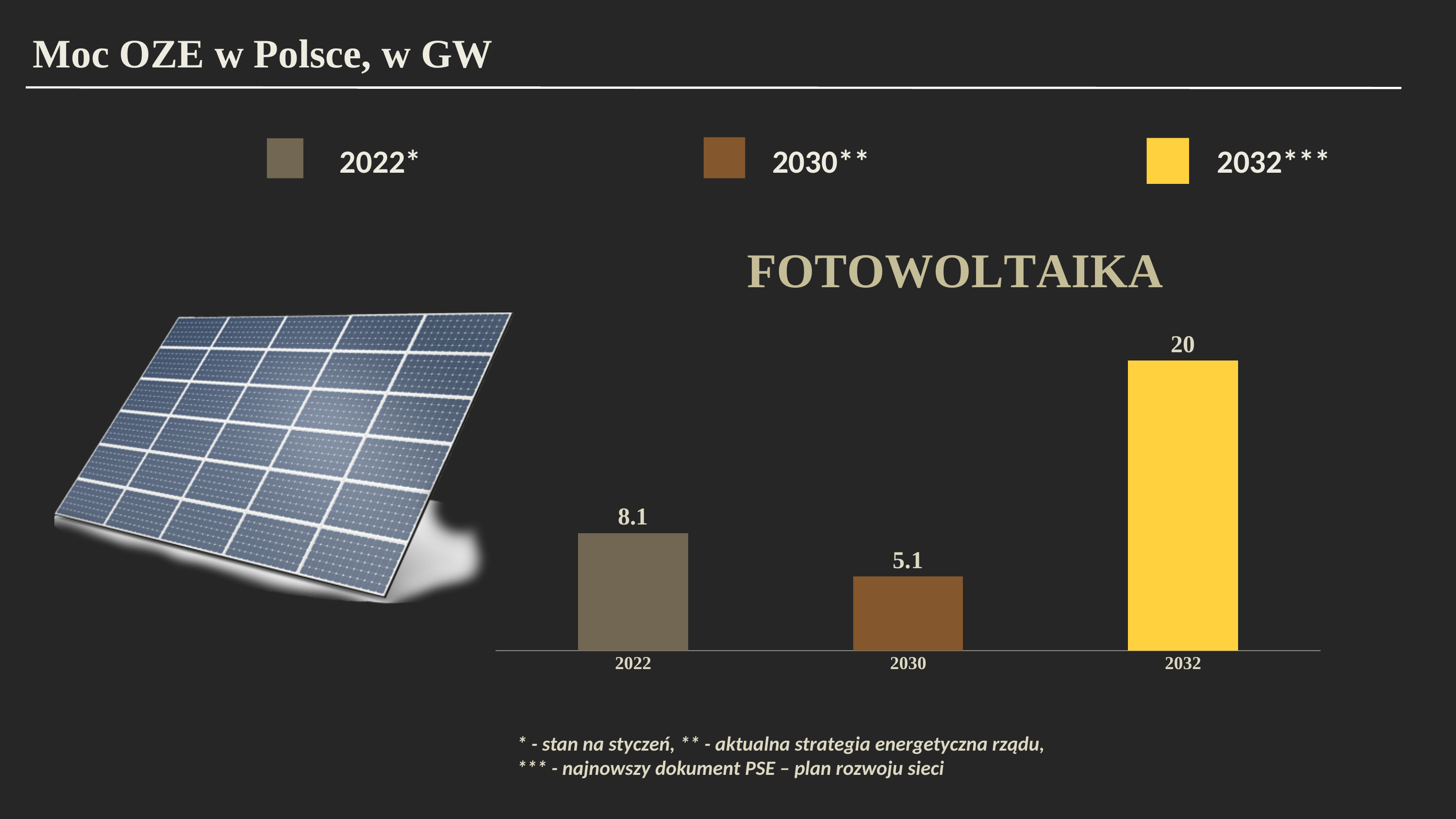
What is the difference between the values for 2022 and 2030 in the FOTOWOLTAIKA chart? 3 What colour is the bar for 2032 in the FOTOWOLTAIKA chart? yellow Which is larger in the FOTOWOLTAIKA chart, the value for 2022 or the value for 2030? 2022 What kind of chart is shown on the slide? bar chart What is the value for 2032 in the FOTOWOLTAIKA chart? 20 What is the value for 2030 in the FOTOWOLTAIKA chart? 5.1 What is the difference between the values for 2032 and 2022 in the FOTOWOLTAIKA chart? 11.9 How many bars are shown in the FOTOWOLTAIKA chart? 3 Which year has the lowest value in the FOTOWOLTAIKA chart? 2030 What is the value for 2022 in the FOTOWOLTAIKA chart? 8.1 How many entries does the legend list? 3 Which year has the highest value in the FOTOWOLTAIKA chart? 2032